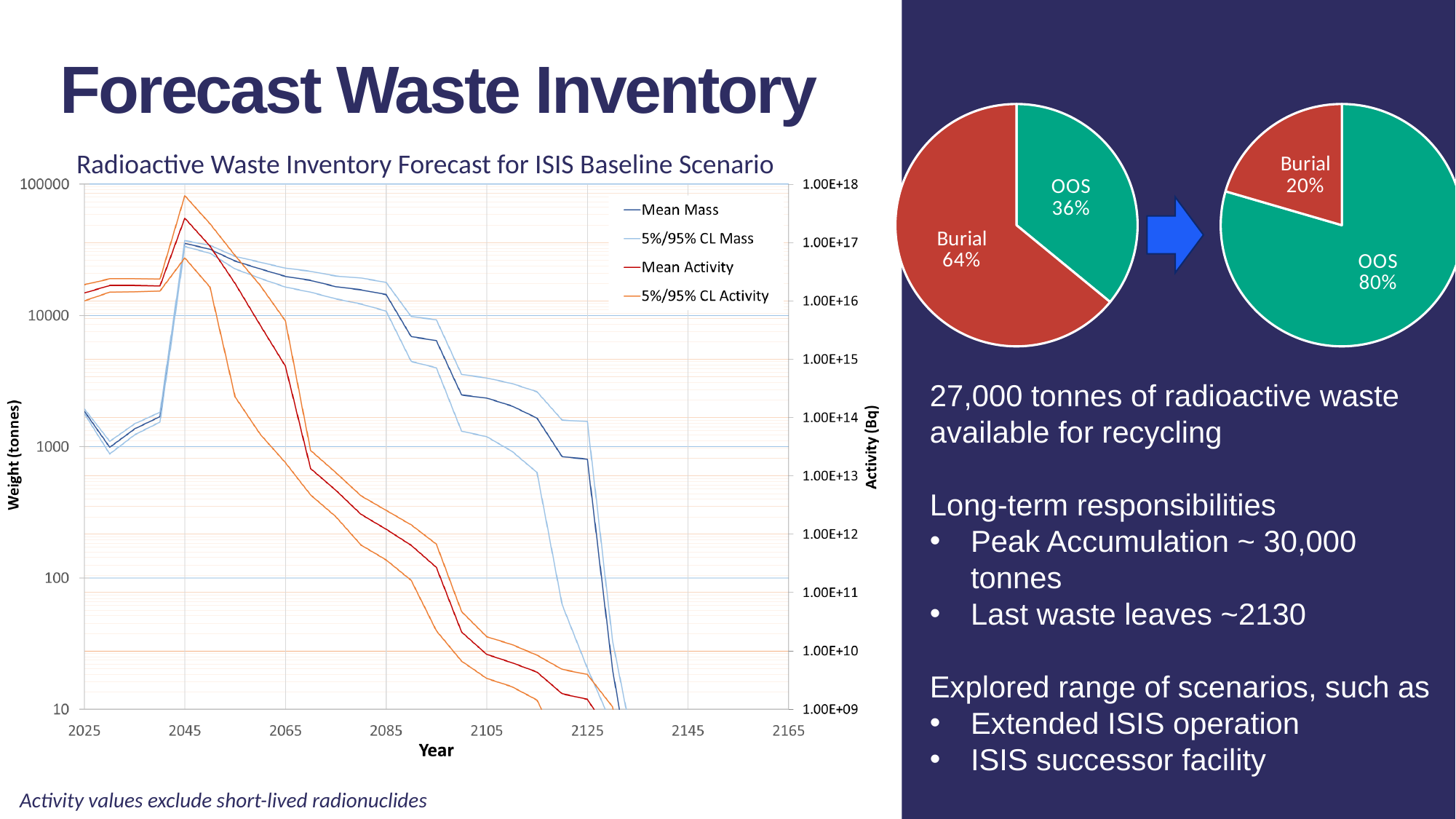
In the Radioactive Waste Inventory Forecast chart, does the Mean Mass line rise or fall between 2045 and 2125? Fall In the right pie chart, which slice is larger, Burial or OOS? OOS In the left pie chart, which slice is larger, Burial or OOS? Burial What kind of chart is the Radioactive Waste Inventory Forecast for ISIS Baseline Scenario chart? Line chart By how many percentage points does the Burial share in the left pie chart exceed the Burial share in the right pie chart? 44 percentage points In the right pie chart, what share of the waste is OOS? 80% In the left pie chart, what share of the waste goes to Burial? 64% How many series does the legend of the Radioactive Waste Inventory Forecast chart list? 4 In the right pie chart, what share of the waste goes to Burial? 20% What is the label of the left vertical axis of the Radioactive Waste Inventory Forecast chart? Weight (tonnes) In the Radioactive Waste Inventory Forecast chart, is the Mean Mass value at 2045 greater or less than 10000 tonnes? greater